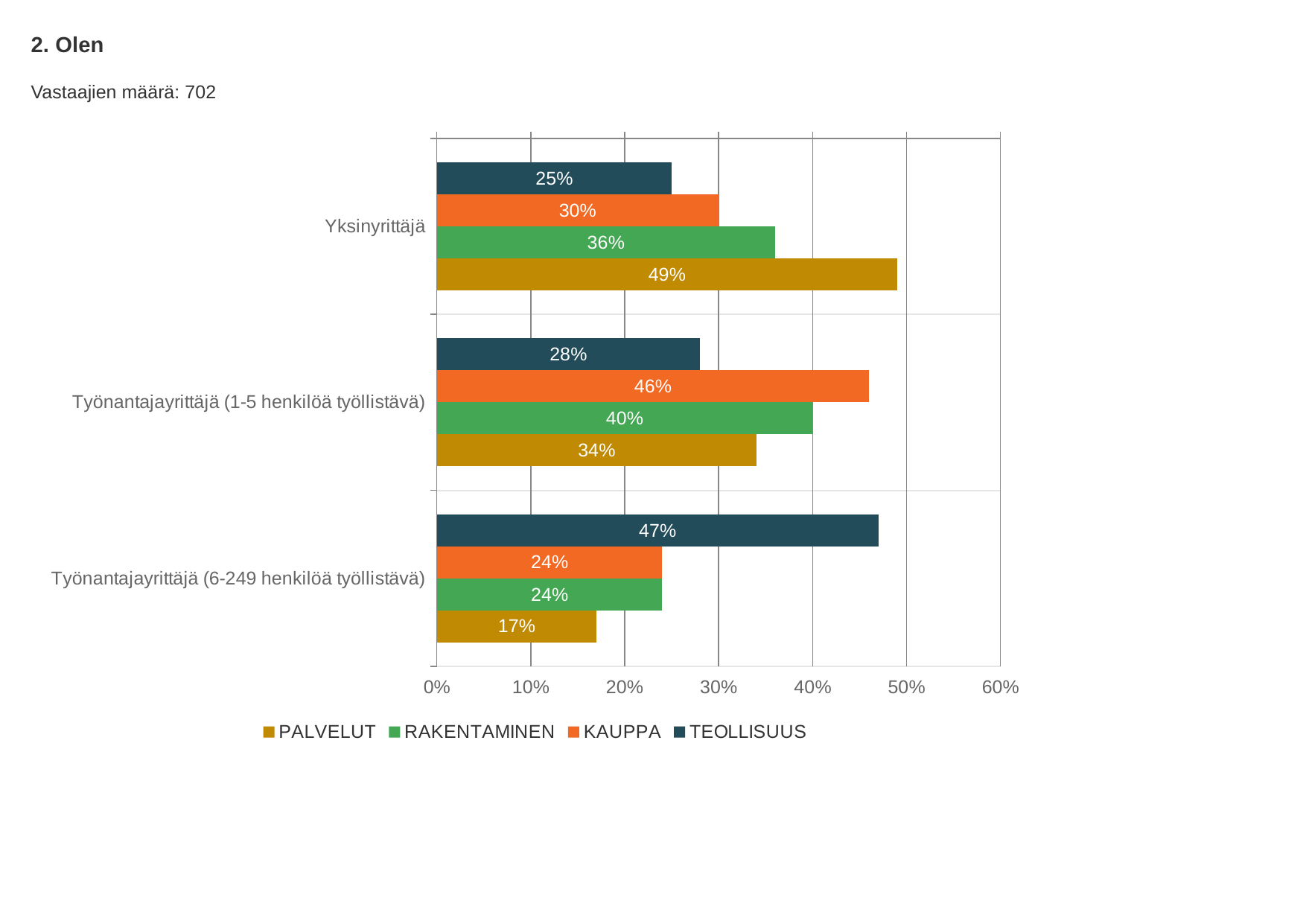
Which category has the lowest TEOLLISUUS value? Yksinyrittäjä How many series does the legend list? 4 What is the number of respondents (Vastaajien määrä) stated on the slide? 702 Which is larger for Työnantajayrittäjä (1-5 henkilöä työllistävä): the KAUPPA value or the TEOLLISUUS value? KAUPPA What kind of chart is shown on the slide? Bar chart What is the PALVELUT value for Yksinyrittäjä? 49% What is the KAUPPA value for Työnantajayrittäjä (1-5 henkilöä työllistävä)? 46% What is the RAKENTAMINEN value for Yksinyrittäjä? 36% How many categories are shown on the y axis? 3 Which category has the highest PALVELUT value? Yksinyrittäjä What is the TEOLLISUUS value for Työnantajayrittäjä (6-249 henkilöä työllistävä)? 47% What is the difference between the PALVELUT values for Yksinyrittäjä and Työnantajayrittäjä (6-249 henkilöä työllistävä)? 32%